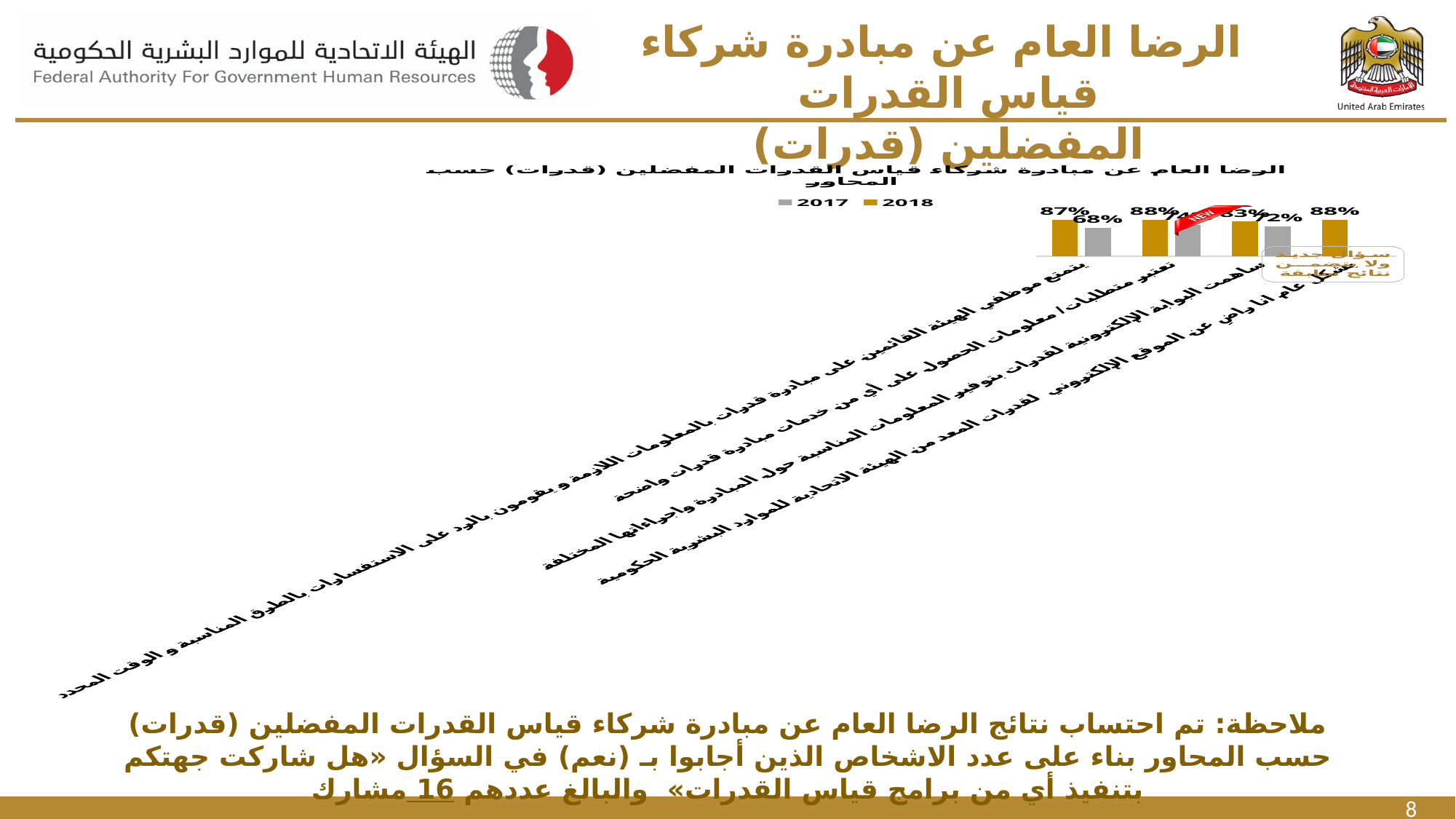
What is the 2017 value for the leftmost category group (يتمتع موظفي الهيئة القائمين على مبادرة قدرات بالمعلومات اللازمة)? 68% What is the 2017 value for the category ساهمت البوابة الإلكترونية لقدرات بتوفير المعلومات المناسبة (third group from the left)? 72% Which category group has only a 2018 bar and no 2017 bar? The rightmost group (بشكل عام انا راض عن الموقع الإلكتروني لقدرات), marked as a new question How many series does the chart legend list? 2 What is the 2018 value for the category ساهمت البوابة الإلكترونية لقدرات بتوفير المعلومات المناسبة (third group from the left)? 83% What is the 2018 value for the leftmost category group (يتمتع موظفي الهيئة القائمين على مبادرة قدرات بالمعلومات اللازمة)? 87% By how many percentage points did the leftmost category (يتمتع موظفي الهيئة...) increase from 2017 to 2018? 19 percentage points What is the 2018 value for the rightmost category group (بشكل عام انا راض عن الموقع الإلكتروني لقدرات)? 88% What kind of chart is shown on the slide? Bar chart How many category groups of bars are plotted in the chart? 4 What are the two series named in the chart legend? 2017 and 2018 Which 2018 bar has the lowest value in the chart? ساهمت البوابة الإلكترونية لقدرات بتوفير المعلومات المناسبة (third group from the left), 83%